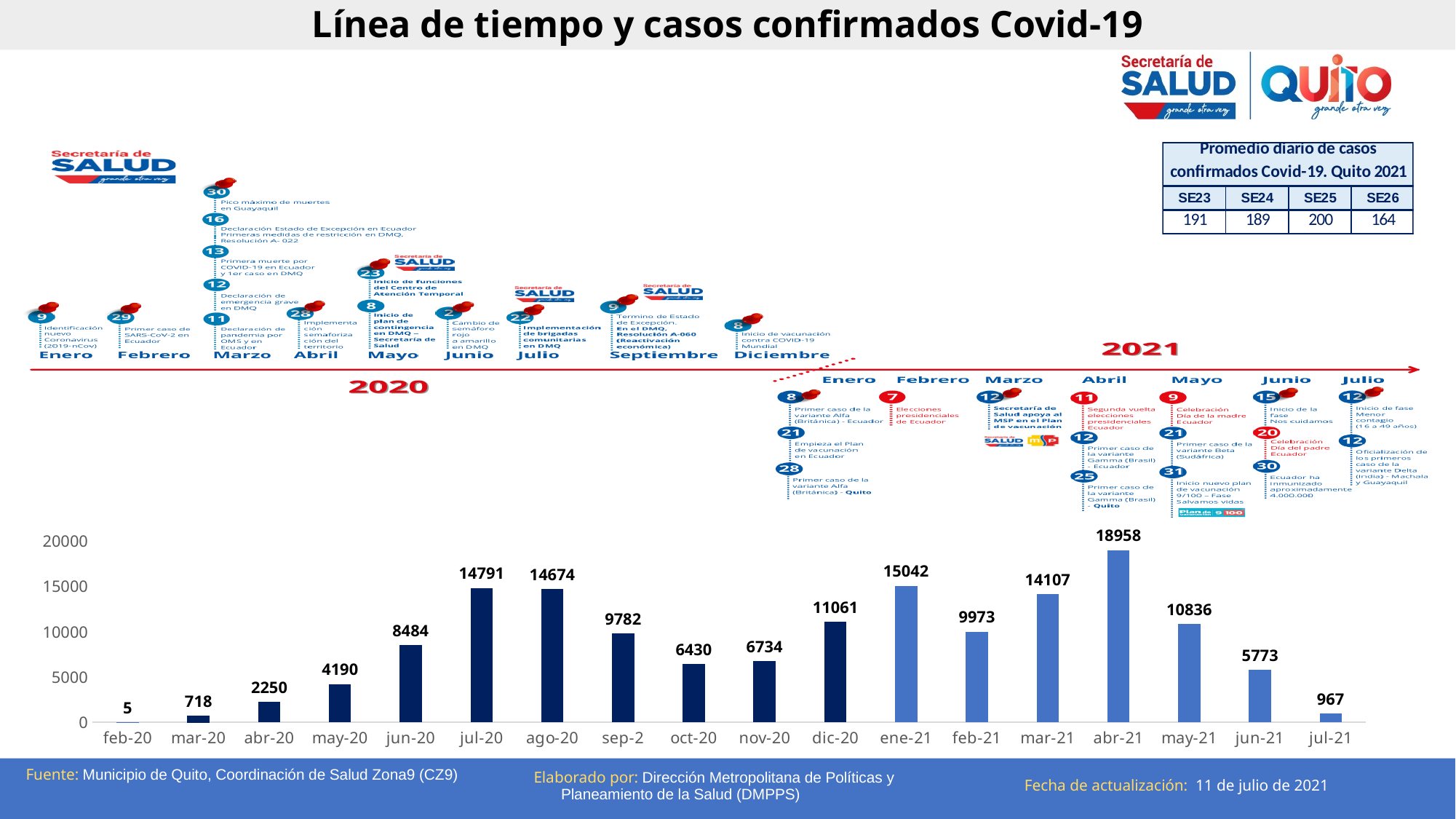
Is the value for dic-20 greater or less than 10000? greater How many months are shown in the bar chart? 18 What is the value for feb-20 in the bar chart? 5 Which month has the highest value in the bar chart? abr-21 What kind of chart is used to show the monthly confirmed cases? bar chart Which is larger in the bar chart, the value for jul-20 or the value for ago-20? jul-20 What is the value for abr-21 in the bar chart? 18958 Do the values in the bar chart rise or fall from abr-21 to jul-21? fall What is the difference between the values for abr-21 and ene-21 in the bar chart? 3916 What is the difference between the values for jun-21 and jul-21 in the bar chart? 4806 Which month has the lowest value in the bar chart? feb-20 What is the value for jul-20 in the bar chart? 14791